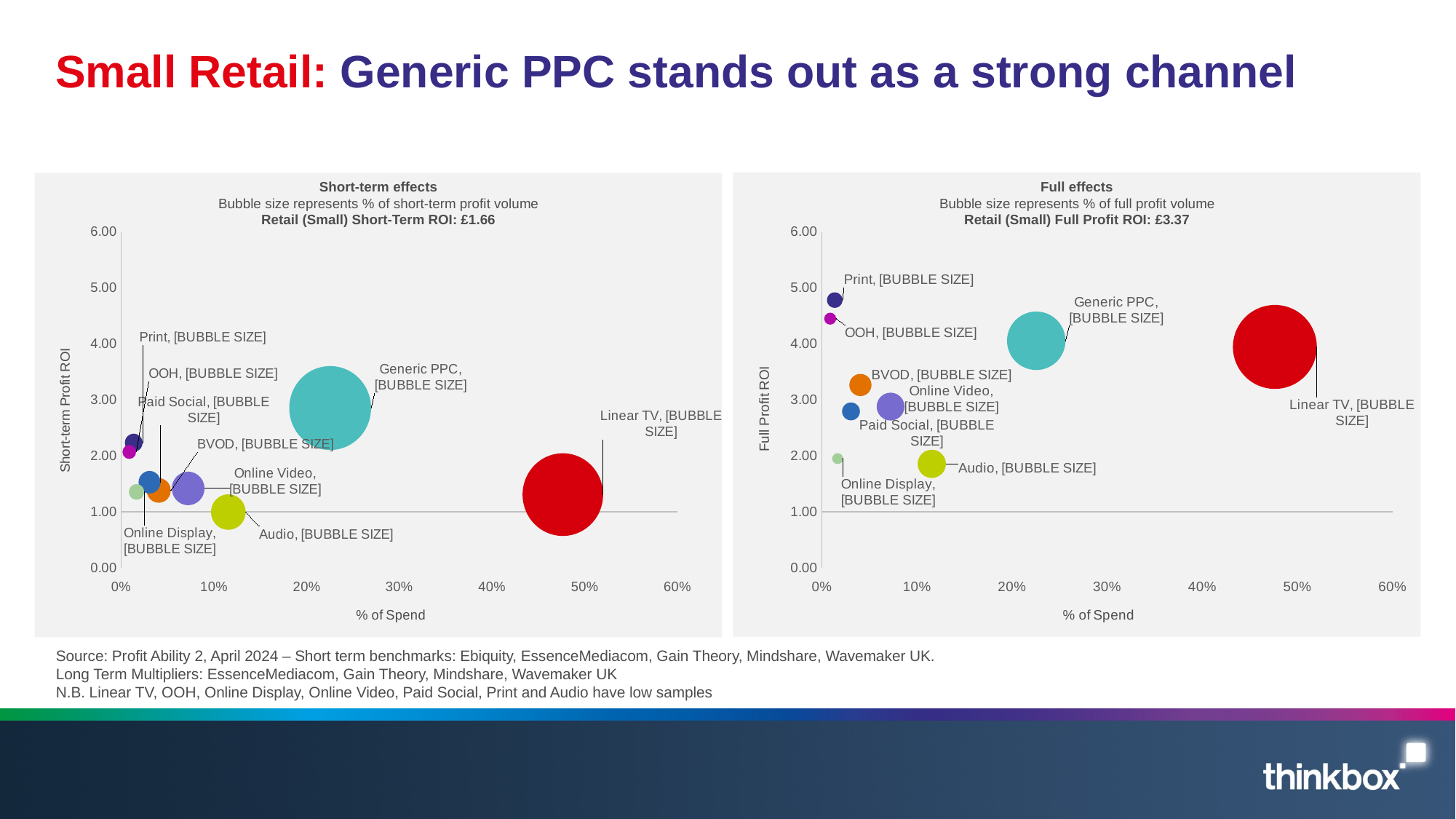
What Retail (Small) Short-Term ROI is stated in the title of the 'Short-term effects' chart? £1.66 On the 'Short-term effects' chart, is the Short-term Profit ROI for Generic PPC greater or less than 2.00? greater On the 'Short-term effects' chart, is the % of Spend for Linear TV greater or less than 40%? greater On the 'Full effects' chart, which has the higher Full Profit ROI, BVOD or Audio? BVOD On the 'Full effects' chart, which channel has the highest Full Profit ROI? Print On the 'Full effects' chart, is the Full Profit ROI for Linear TV greater or less than 3.00? greater What kind of chart is the 'Short-term effects' chart? Bubble chart On the 'Short-term effects' chart, which channel has the highest Short-term Profit ROI? Generic PPC How many channels are plotted on the 'Full effects' chart? 9 What Retail (Small) Full Profit ROI is stated in the title of the 'Full effects' chart? £3.37 On the 'Short-term effects' chart, which channel has the lowest Short-term Profit ROI? Audio